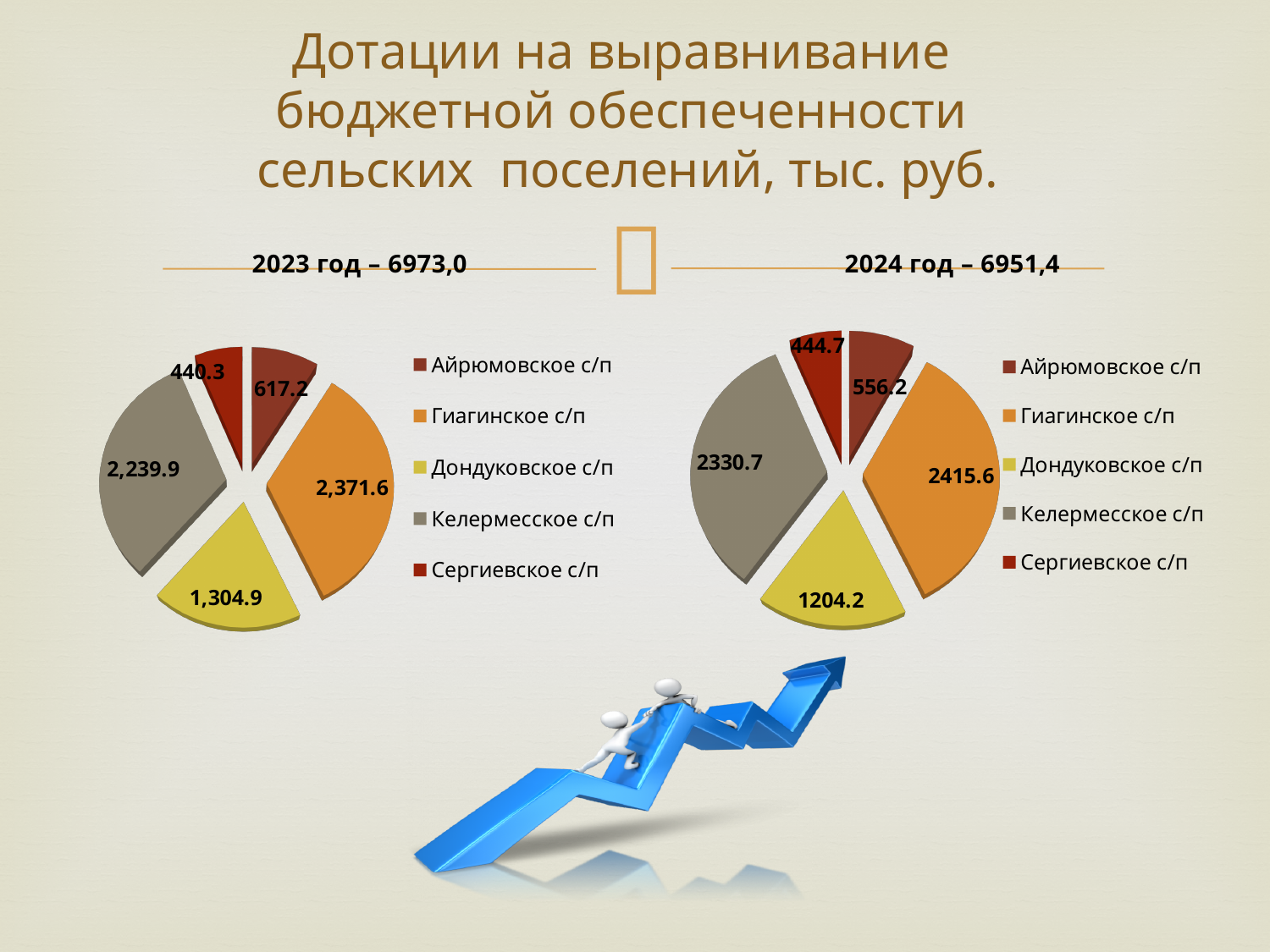
In the 2023 pie chart, what is the difference between Гиагинское с/п and Келермесское с/п? 131.7 What colour is the Дондуковское с/п slice in the legend? Yellow In the 2024 pie chart, what is the value for Келермесское с/п? 2330.7 In the 2024 pie chart, what is the difference between Айрюмовское с/п and Сергиевское с/п? 111.5 Is the value for Гиагинское с/п larger in the 2023 chart or the 2024 chart? 2024 In the 2023 pie chart, what is the value for Гиагинское с/п? 2,371.6 In the 2023 pie chart, which settlement has the largest value? Гиагинское с/п What type of chart is used for the 2023 data? Pie chart In the 2023 pie chart, what is the value for Сергиевское с/п? 440.3 How many slices does the 2024 pie chart have? 5 In the 2024 pie chart, what is the value for Дондуковское с/п? 1204.2 In the 2024 pie chart, which settlement has the smallest value? Сергиевское с/п